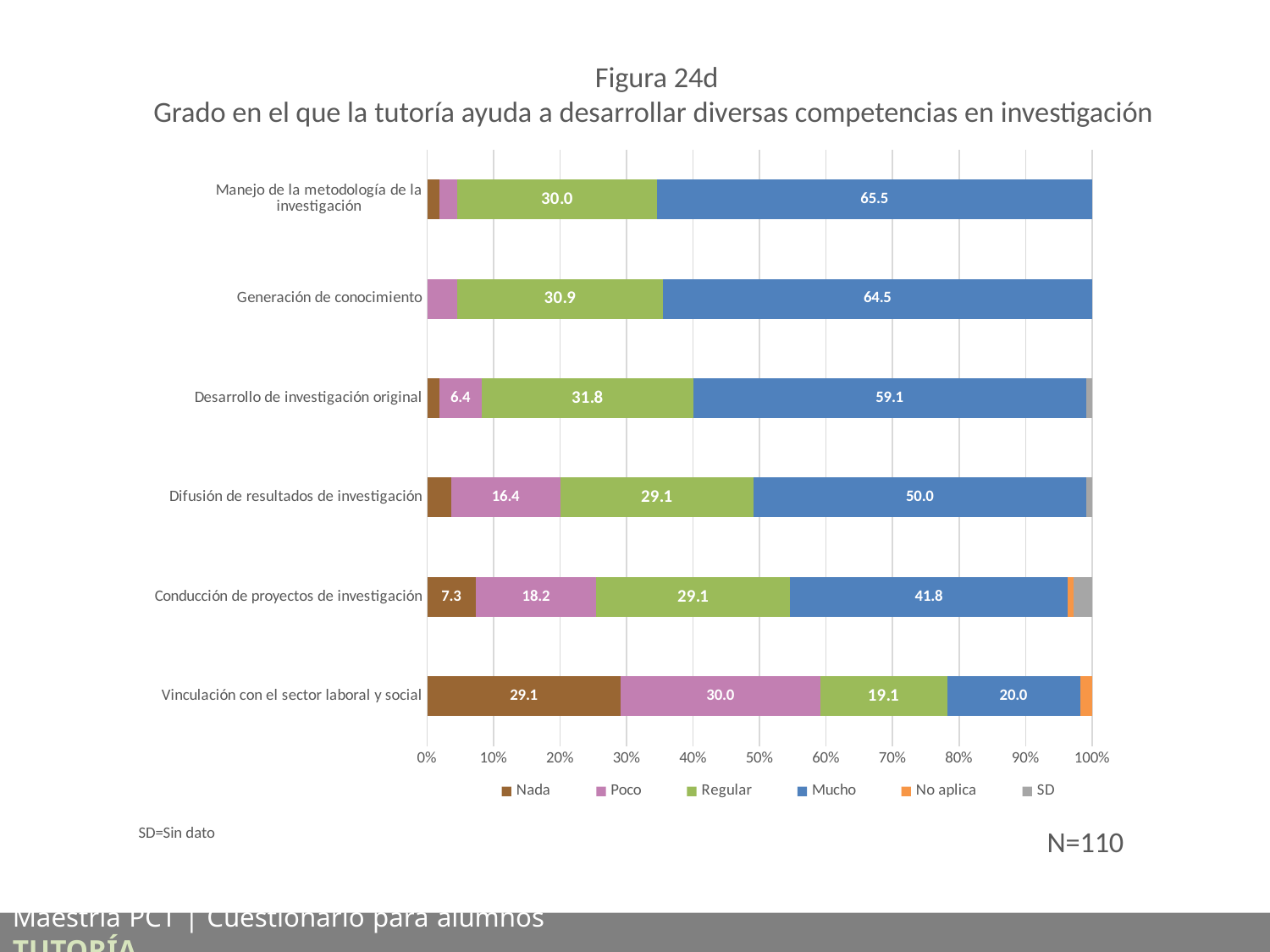
Which is larger: the "Poco" value for "Conducción de proyectos de investigación" or the "Poco" value for "Difusión de resultados de investigación"? Conducción de proyectos de investigación What is the value of "Poco" for "Difusión de resultados de investigación"? 16.4 What is the value of "Mucho" for "Manejo de la metodología de la investigación"? 65.5 What is the value of "Nada" for "Vinculación con el sector laboral y social"? 29.1 What is the difference between the "Mucho" values for "Desarrollo de investigación original" and "Difusión de resultados de investigación"? 9.1 How many categories are shown on the y axis? 6 What is the value of "Regular" for "Generación de conocimiento"? 30.9 Which category has the highest value for "Mucho"? Manejo de la metodología de la investigación How many series does the legend list? 6 What does the note below the chart say SD stands for? Sin dato What kind of chart is this? Stacked bar chart Which category has the lowest value for "Mucho"? Vinculación con el sector laboral y social